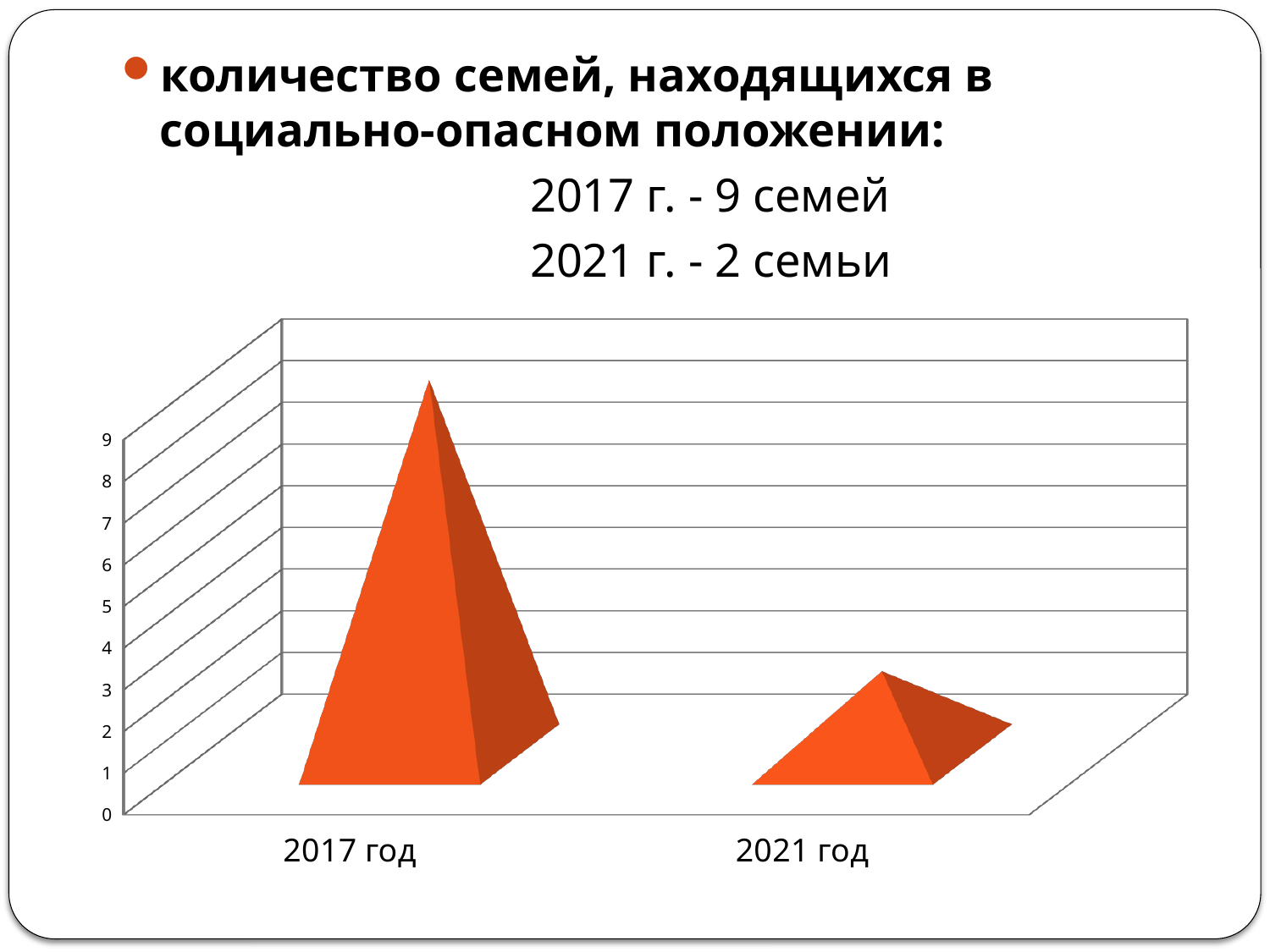
By how much did the number of families decrease from 2017 to 2021? 7 What colour are the bars in the chart? orange Do the values rise or fall from 2017 год to 2021 год? fall According to the slide, how many families were in a socially dangerous situation in 2017? 9 Which is larger, the value for 2017 год or the value for 2021 год? 2017 год What kind of chart is shown on the slide? bar chart What is the highest tick value shown on the vertical axis of the chart? 9 According to the slide, how many families were in a socially dangerous situation in 2021? 2 Is the value for 2021 год greater or less than 5? less How many categories are shown on the x axis of the chart? 2 Which category has the lowest value in the chart? 2021 год Which category has the highest value in the chart? 2017 год